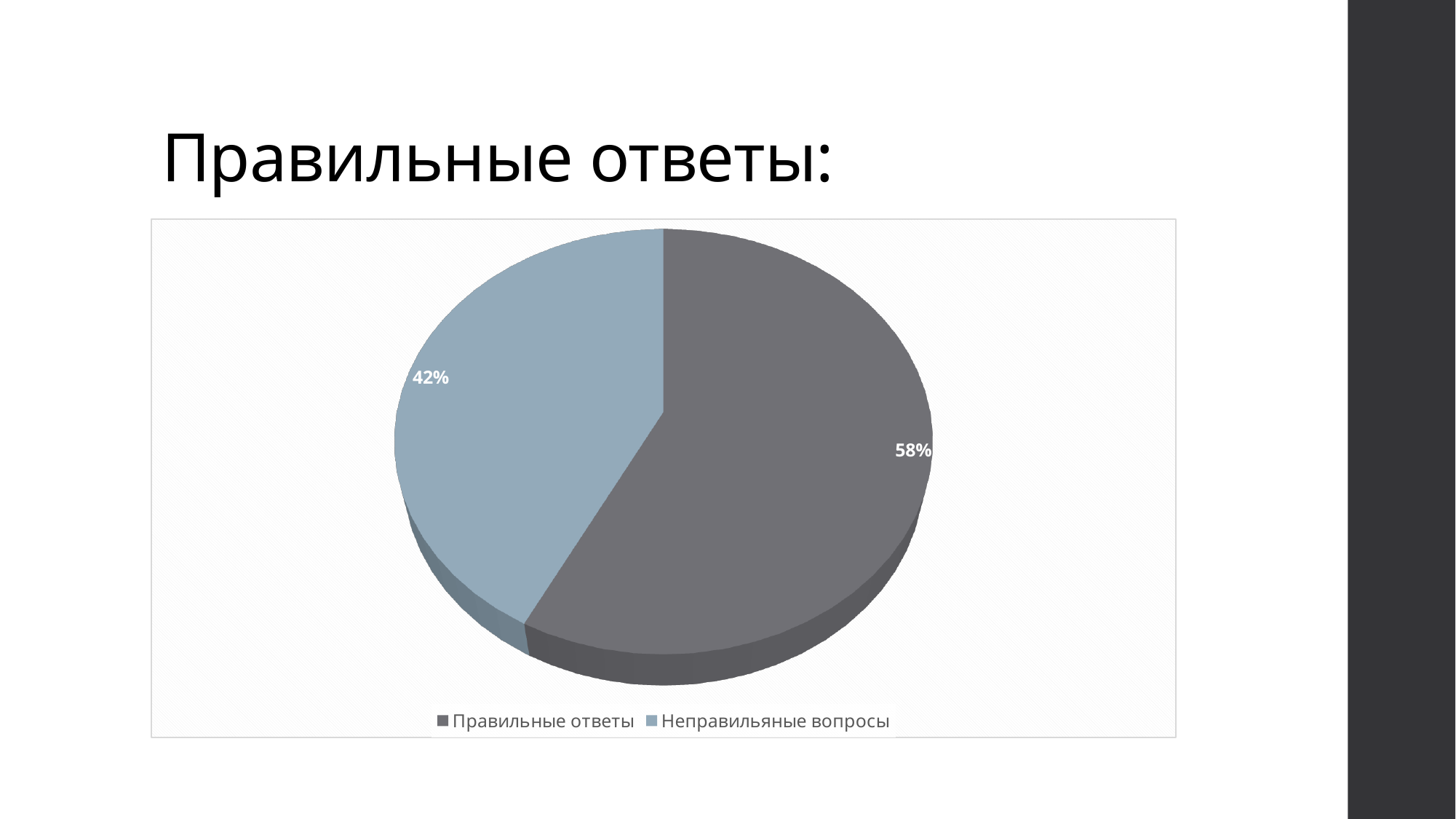
What share of the pie is labelled "Правильные ответы"? 58% What colour is the "Неправильяные вопросы" slice? light blue-grey What is the difference in percentage points between the "Правильные ответы" slice and the "Неправильяные вопросы" slice? 16% Which slice is the largest? Правильные ответы Which is larger: the "Правильные ответы" slice or the "Неправильяные вопросы" slice? Правильные ответы What kind of chart is shown on the slide? pie chart How many entries does the legend list? 2 Which slice is the smallest? Неправильяные вопросы What is the title of the slide above the chart? Правильные ответы: What share of the pie is labelled "Неправильяные вопросы"? 42% How many slices does the pie chart have? 2